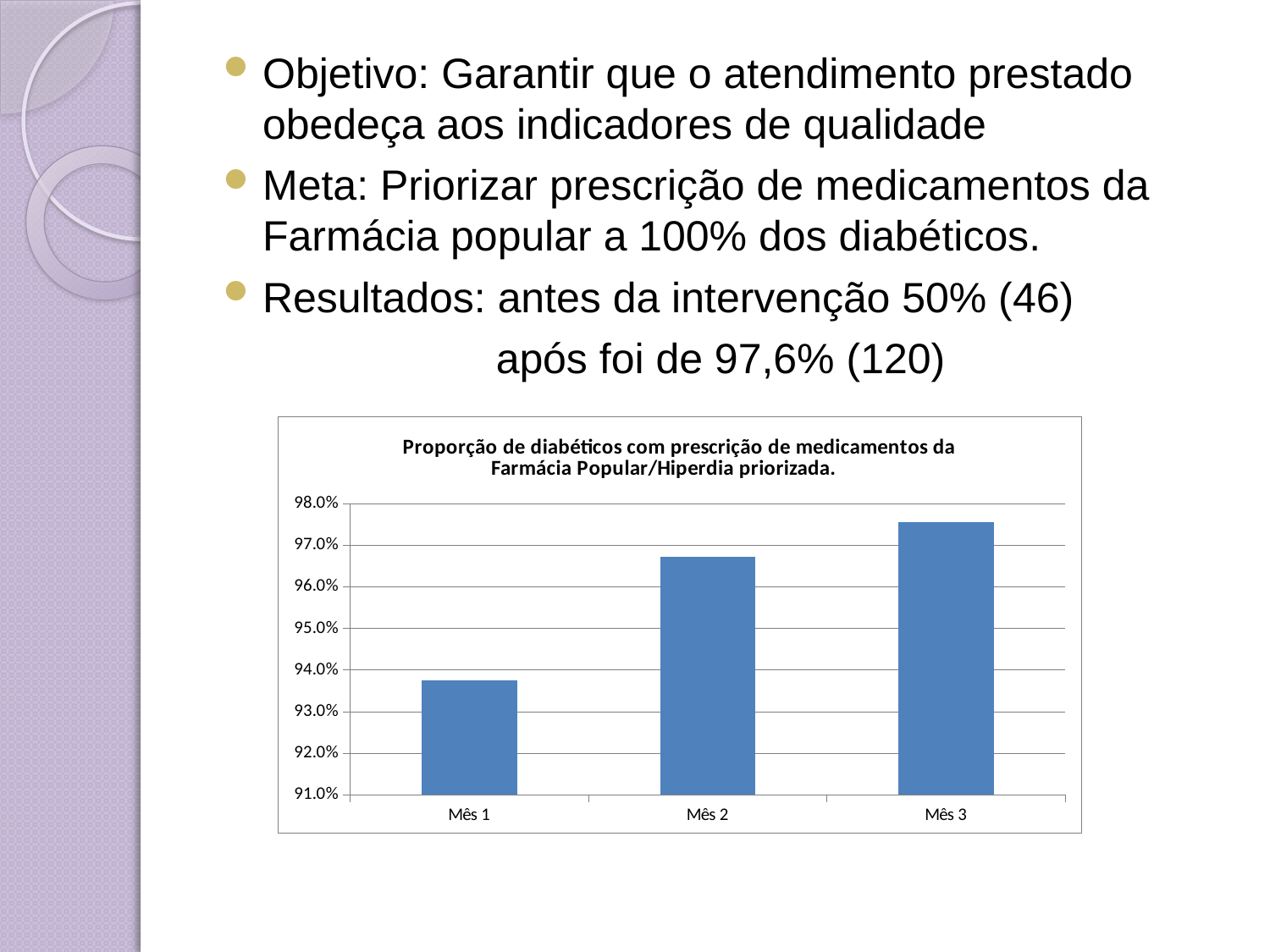
Is the value for Mês 1 greater or less than 94.0%? less Is the value for Mês 3 greater or less than 97.0%? greater How many categories (months) are plotted on the chart? 3 Is the value for Mês 2 greater or less than 97.0%? less Do the values rise or fall from Mês 1 to Mês 3? rise Which month has the highest proportion of diabetics with prioritized prescriptions? Mês 3 What is the lowest value shown on the vertical axis of the chart? 91.0% Which is larger, the value for Mês 1 or the value for Mês 2? Mês 2 What is the title of the chart? Proporção de diabéticos com prescrição de medicamentos da Farmácia Popular/Hiperdia priorizada. Which month has the lowest proportion of diabetics with prioritized prescriptions? Mês 1 What kind of chart is shown on the slide? bar chart